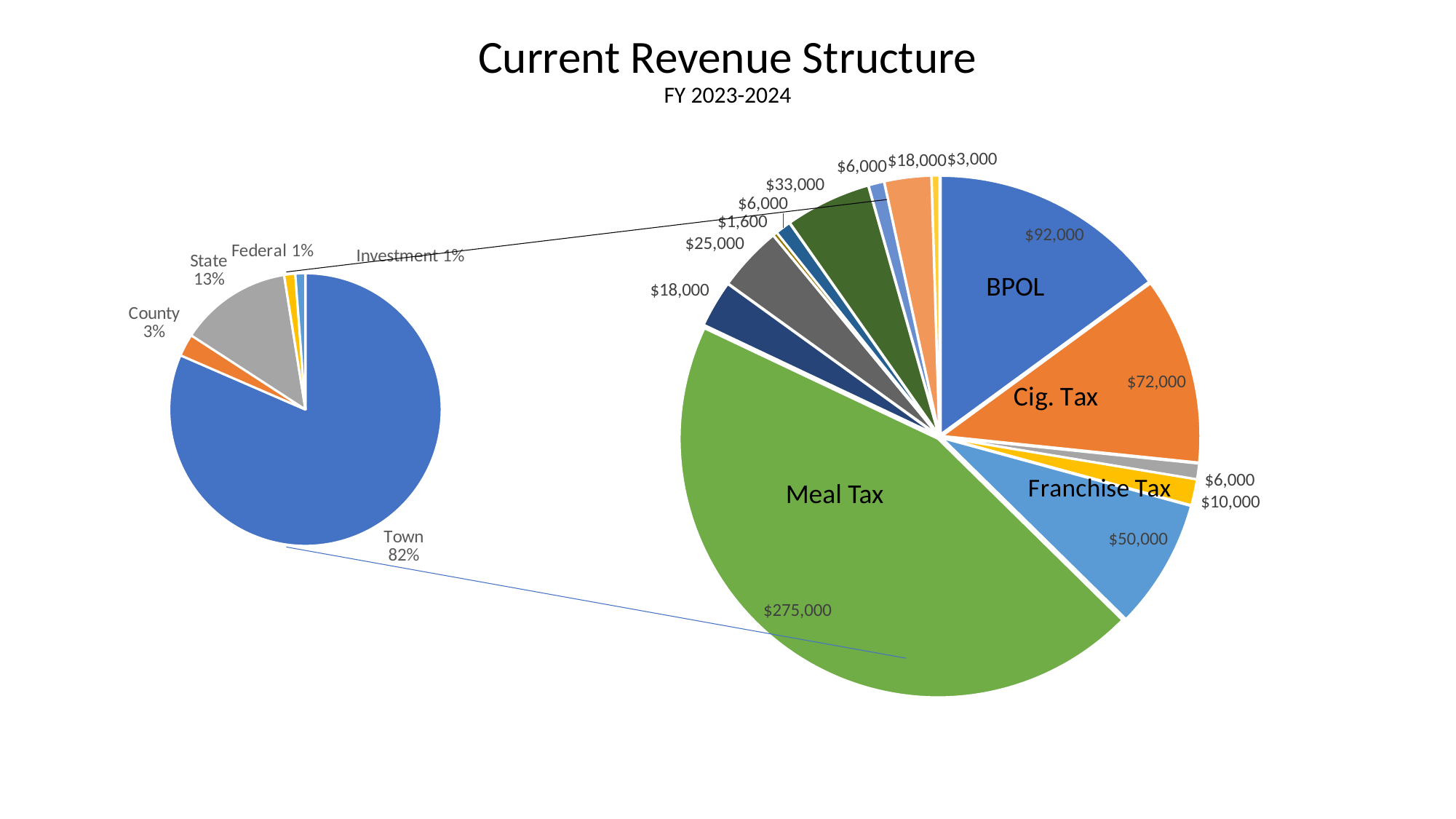
In the larger pie, which is larger, BPOL or Cig. Tax? BPOL What fiscal year does the chart cover? FY 2023-2024 In the smaller pie, what share of revenue comes from the Town? 82% How many revenue sources are shown in the smaller pie? 5 In the larger pie, what is the difference between BPOL and Cig. Tax? $20,000 What kind of chart is shown on the slide? Pie chart What is the title of the chart? Current Revenue Structure In the smaller pie, what share of revenue comes from the County? 3% In the smaller pie, what share of revenue comes from the State? 13% In the larger pie, what is the value for Meal Tax? $275,000 In the larger pie, what is the value for BPOL? $92,000 In the smaller pie, which source has the largest share? Town